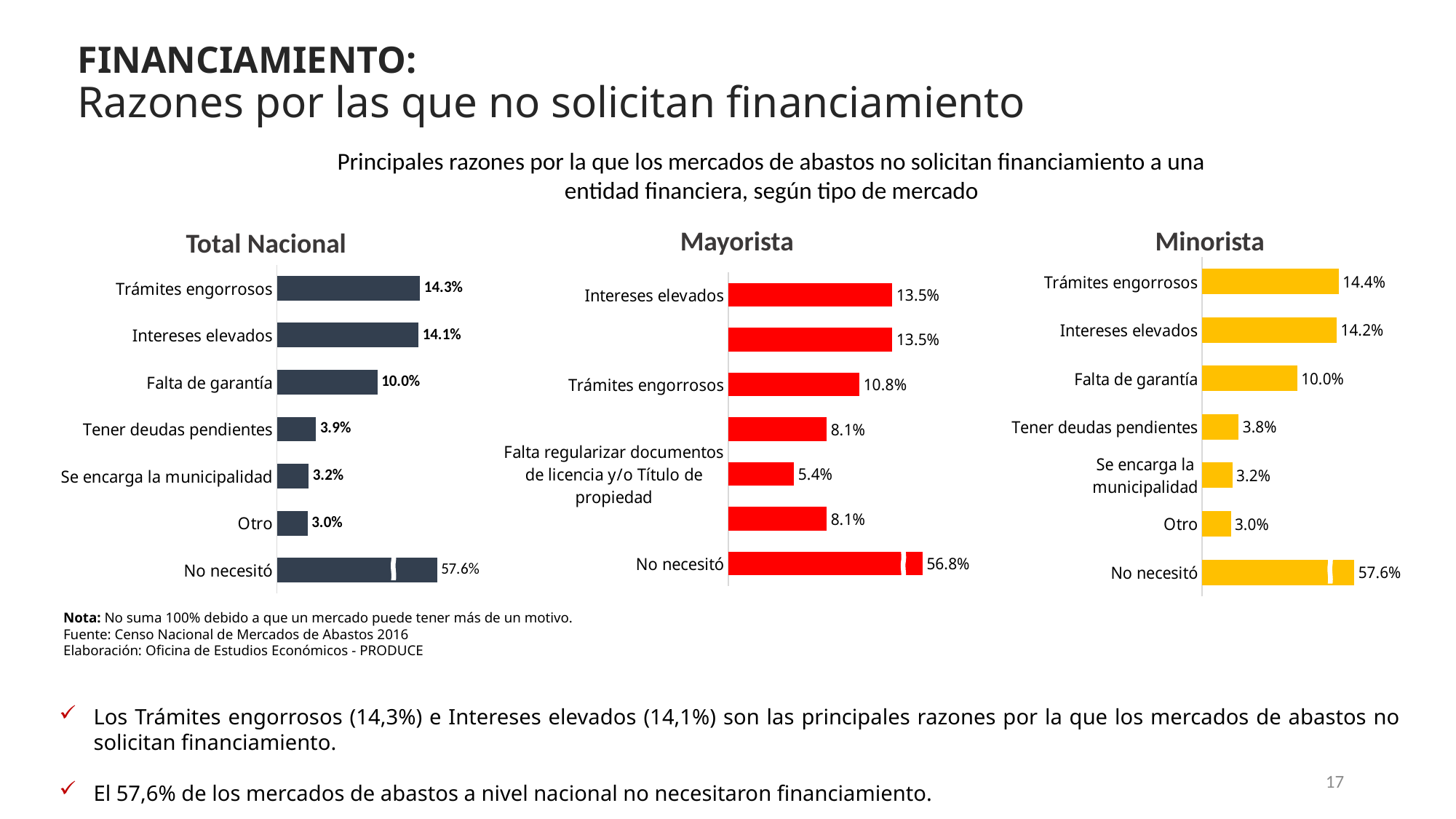
In the Minorista chart, what is the difference between Trámites engorrosos and Falta de garantía? 4.4% In the Total Nacional chart, what is the value for Trámites engorrosos? 14.3% In the Mayorista chart, what is the value for Intereses elevados? 13.5% In the Minorista chart, which category has the highest value? No necesitó How many categories are shown in the Minorista chart? 7 In the Minorista chart, what is the value for Tener deudas pendientes? 3.8% What colour are the bars in the Mayorista chart? Red In the Total Nacional chart, what is the value for Falta de garantía? 10.0% In the Total Nacional chart, which category has the lowest value? Otro What kind of chart is the Total Nacional chart? Bar chart In the Mayorista chart, which is larger: Trámites engorrosos or Falta regularizar documentos de licencia y/o Título de propiedad? Trámites engorrosos In the Total Nacional chart, what is the difference between Trámites engorrosos and Intereses elevados? 0.2%